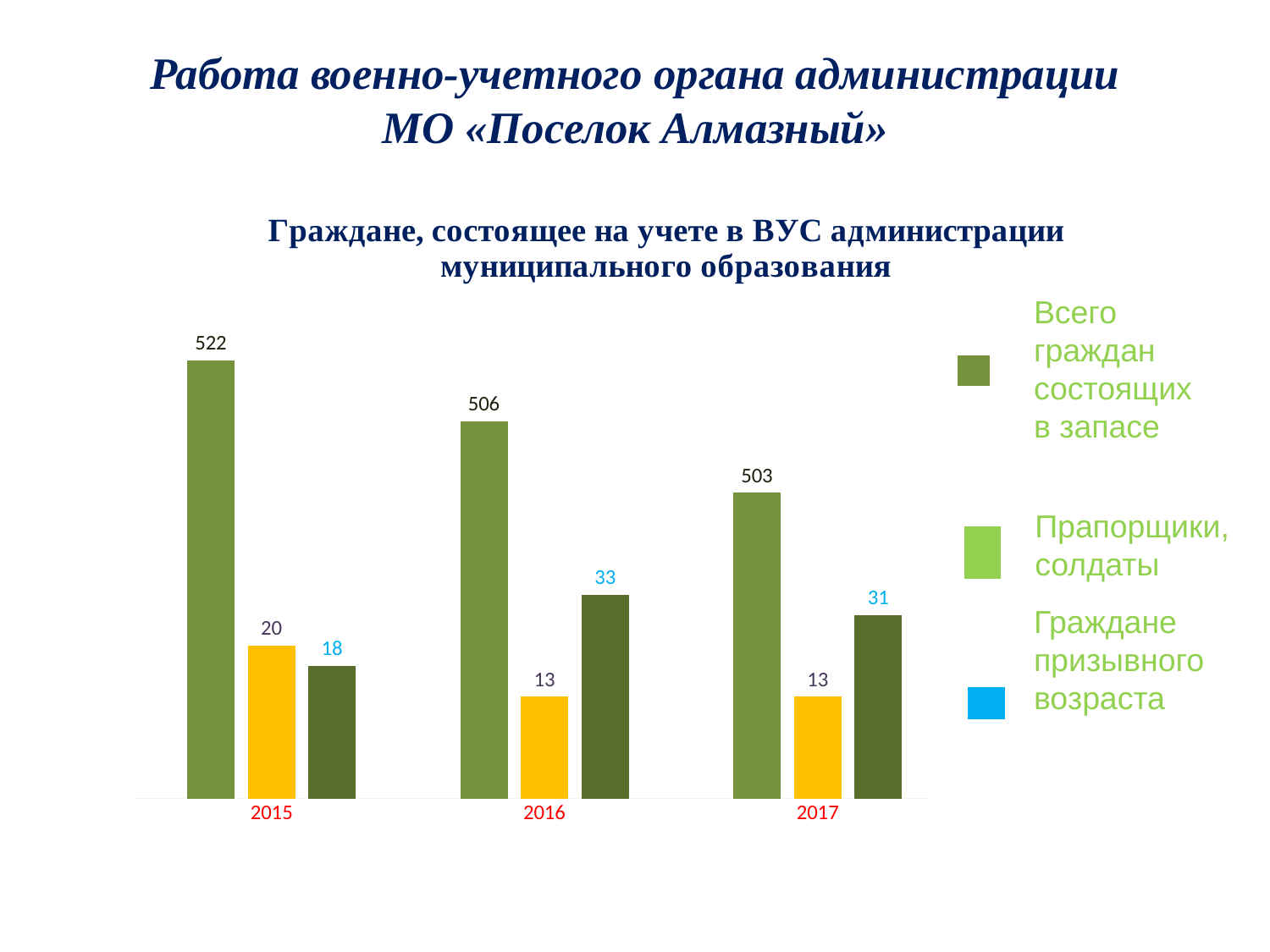
In which year is the tallest bar of the group the highest? 2015 What is the value of the middle (yellow) bar for 2015? 20 How many series does the legend list? 3 What is the difference between the tallest bars for 2015 and 2017? 19 What is the value of the tallest bar for 2015? 522 What type of chart is shown on the slide? bar chart What is the value of the tallest bar for 2017? 503 Do the values of the tallest bars rise or fall from 2015 to 2017? fall Which is larger for 2016: the yellow bar or the dark green bar? the dark green bar In which year is the third (dark green) bar the lowest? 2015 What is the value of the third (dark green) bar for 2016? 33 How many year categories are shown on the x axis? 3